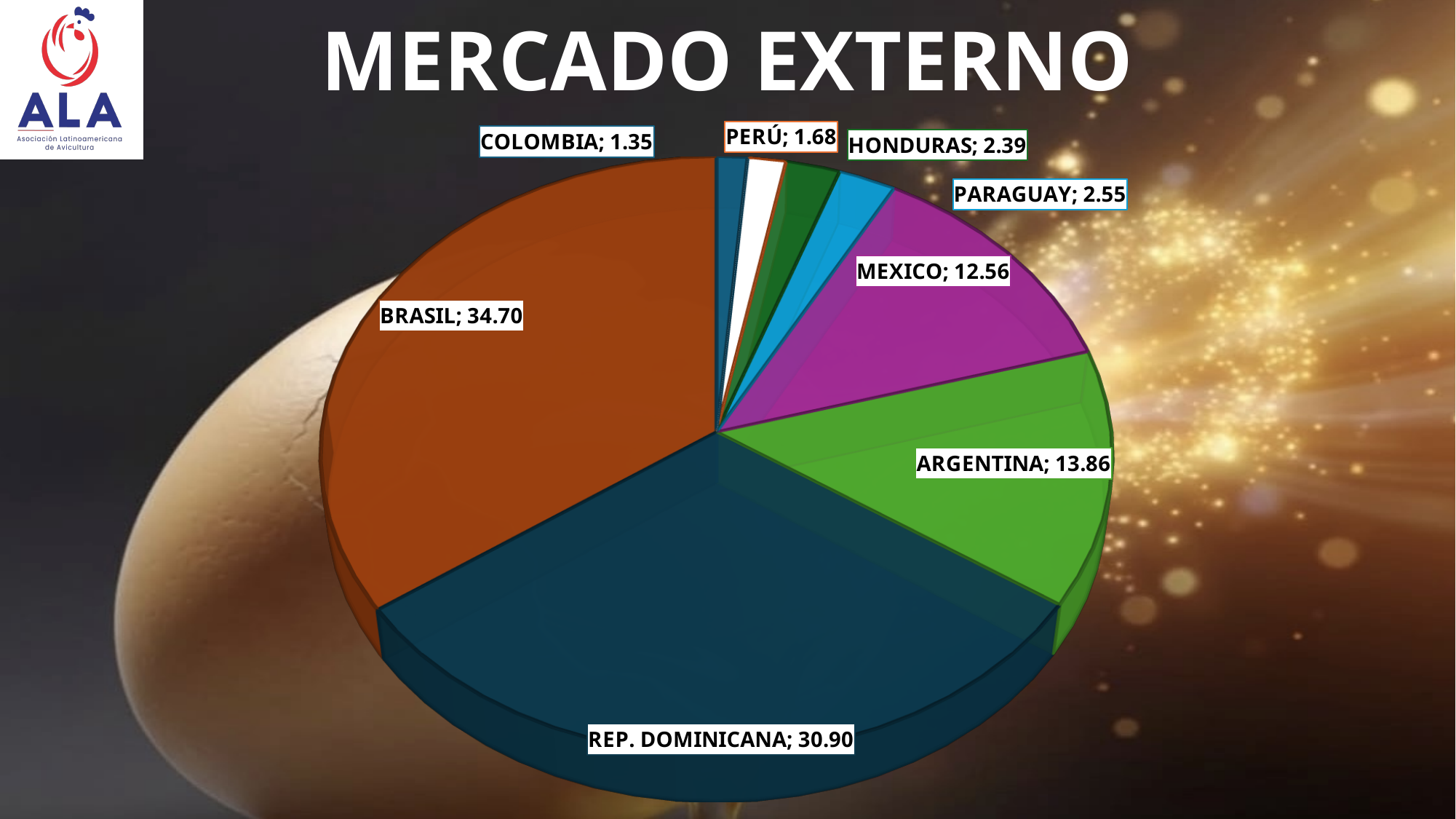
What is the difference between the values for ARGENTINA and MEXICO? 1.30 Which is larger, the value for ARGENTINA or the value for MEXICO? ARGENTINA How many slices does the pie chart have? 8 What type of chart is shown on the slide? Pie chart What is the value shown for HONDURAS? 2.39 What is the value shown for BRASIL? 34.70 What is the title of the chart? MERCADO EXTERNO What is the value shown for MEXICO? 12.56 What is the value shown for REP. DOMINICANA? 30.90 Which category has the smallest slice of the pie? COLOMBIA Which category has the largest slice of the pie? BRASIL What is the difference between the values for BRASIL and REP. DOMINICANA? 3.80